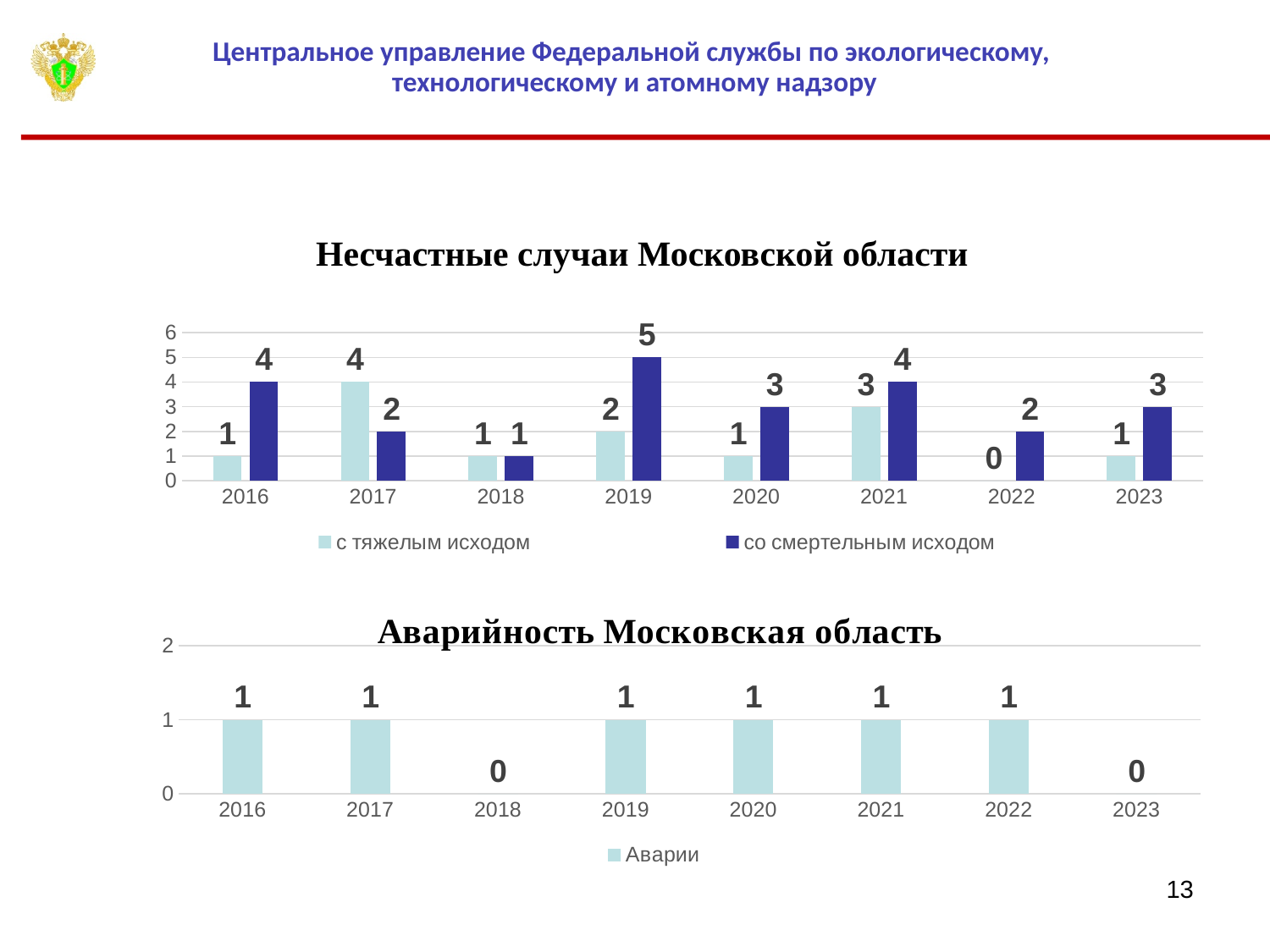
In the chart titled "Несчастные случаи Московской области", how many years are shown on the x axis? 8 In the chart titled "Несчастные случаи Московской области", what is the difference between "со смертельным исходом" and "с тяжелым исходом" in 2016? 3 In the chart titled "Несчастные случаи Московской области", what is the value for "с тяжелым исходом" in 2017? 4 In the chart titled "Несчастные случаи Московской области", which is larger in 2021: "с тяжелым исходом" or "со смертельным исходом"? со смертельным исходом In the chart titled "Аварийность Московская область", what is the value for 2022? 1 In the chart titled "Несчастные случаи Московской области", how many series does the legend list? 2 In the chart titled "Несчастные случаи Московской области", which year has the lowest value for "с тяжелым исходом"? 2022 In the chart titled "Аварийность Московская область", what is the value for 2018? 0 In the chart titled "Несчастные случаи Московской области", what is the value for "со смертельным исходом" in 2019? 5 In the chart titled "Несчастные случаи Московской области", which year has the highest value for "со смертельным исходом"? 2019 What kind of chart is the chart titled "Аварийность Московская область"? bar chart In the chart titled "Аварийность Московская область", what is the name of the series in the legend? Аварии